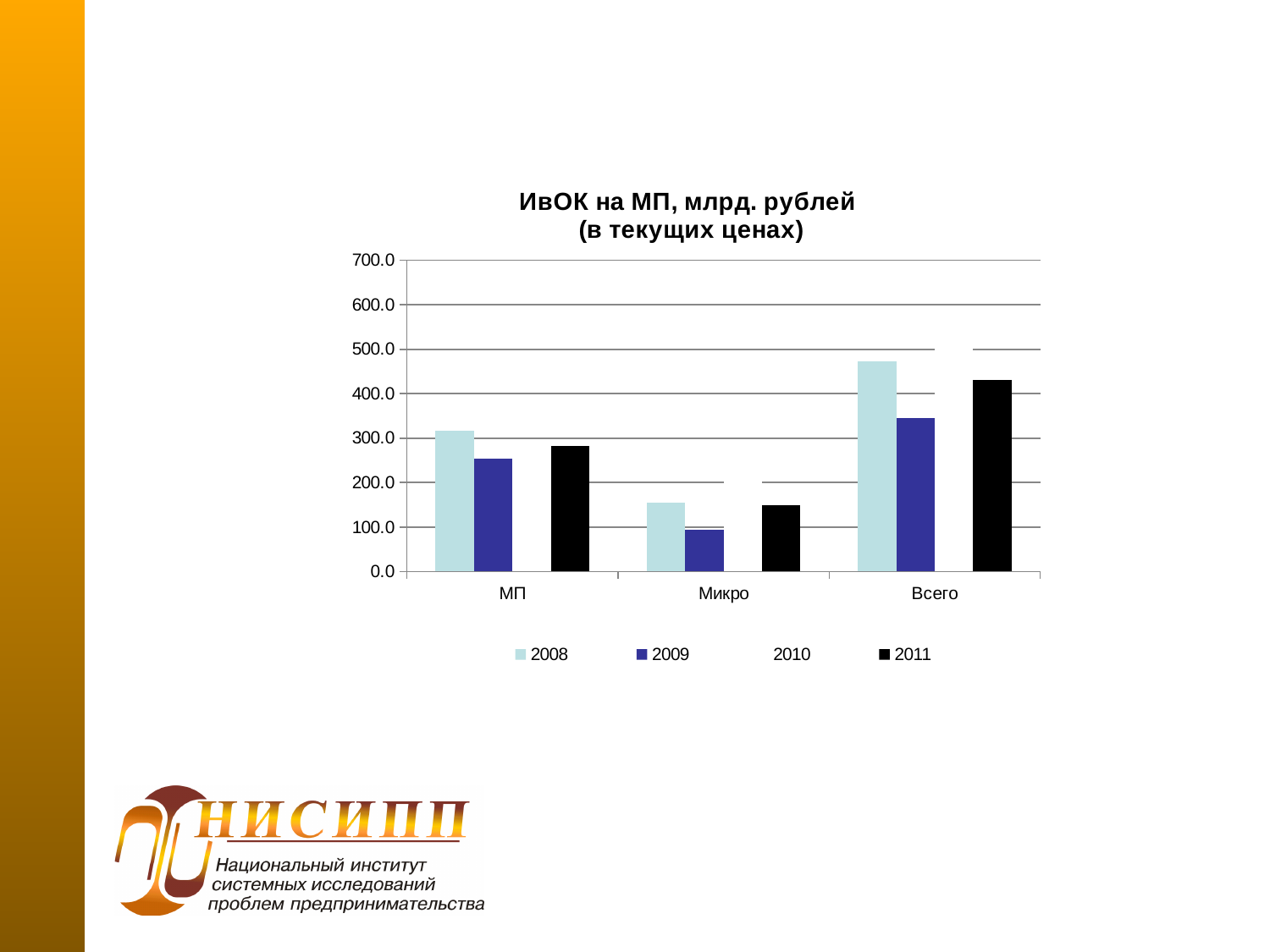
For the МП category, which is larger: the 2008 value or the 2009 value? 2008 Is the 2009 value for Всего greater or less than 300? greater For the Всего category, which is larger: the 2011 value or the 2009 value? 2011 Is the 2009 value for Микро greater or less than 100? less Which category has the lowest 2009 value? Микро Which category has the highest 2008 value? Всего What kind of chart is shown on the slide? bar chart Is the 2011 value for МП greater or less than 300? less How many categories are shown on the x axis of the chart? 3 How many series does the legend list? 4 What is the title of the chart? ИвОК на МП, млрд. рублей (в текущих ценах)